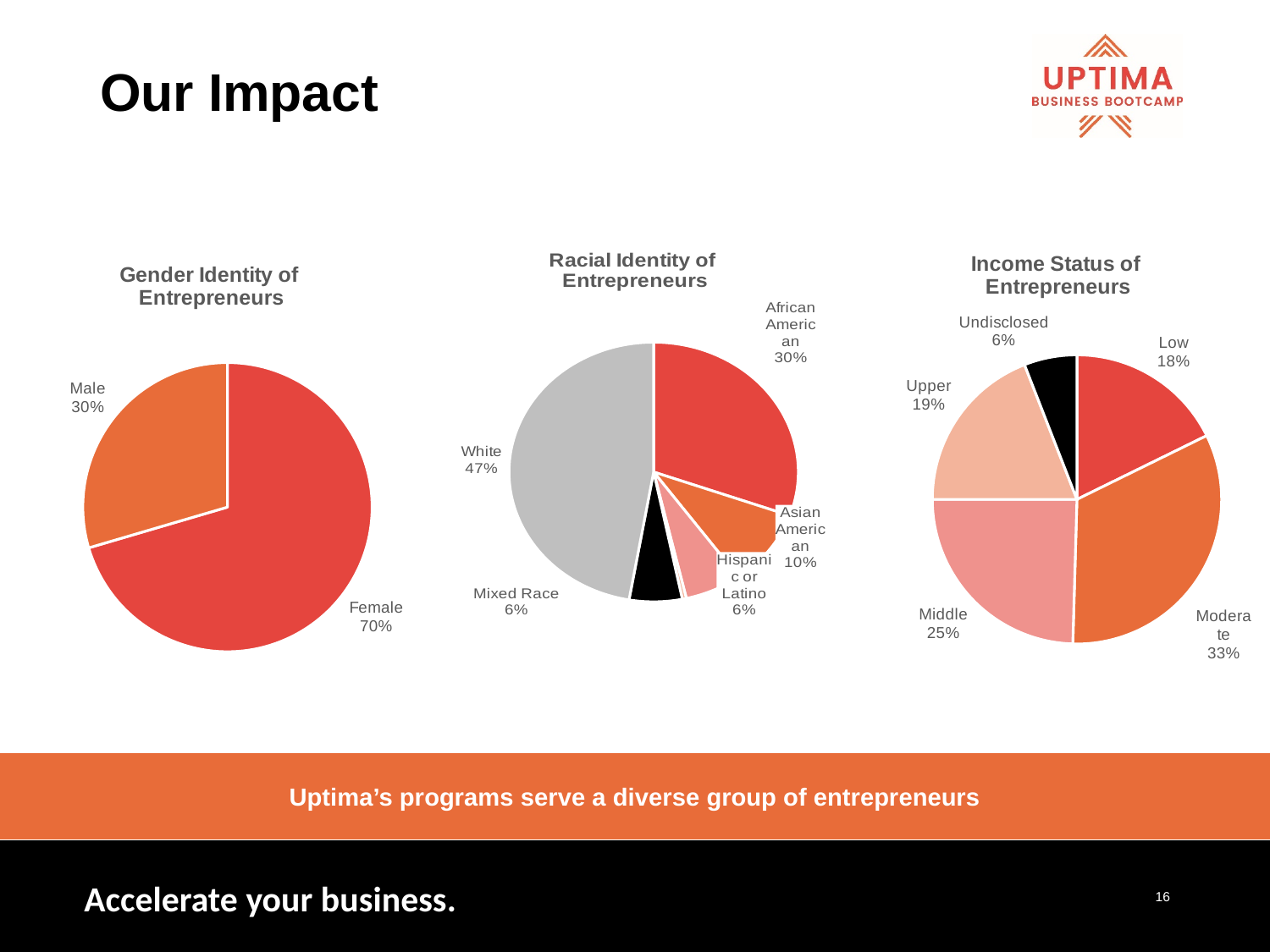
In the 'Gender Identity of Entrepreneurs' chart, what share of entrepreneurs are Female? 70% In the 'Racial Identity of Entrepreneurs' chart, what share is Asian American? 10% In the 'Racial Identity of Entrepreneurs' chart, which is larger: African American or Asian American? African American What kind of chart is the 'Gender Identity of Entrepreneurs' chart? Pie chart In the 'Income Status of Entrepreneurs' chart, what share is Moderate? 33% In the 'Gender Identity of Entrepreneurs' chart, what is the difference between the Female and Male shares? 40% In the 'Racial Identity of Entrepreneurs' chart, which category has the largest share? White How many categories are shown in the 'Income Status of Entrepreneurs' chart? 5 In the 'Income Status of Entrepreneurs' chart, which category has the smallest share? Undisclosed In the 'Income Status of Entrepreneurs' chart, what colour is the Undisclosed slice? Black In the 'Income Status of Entrepreneurs' chart, what is the difference between the Moderate and Middle shares? 8%